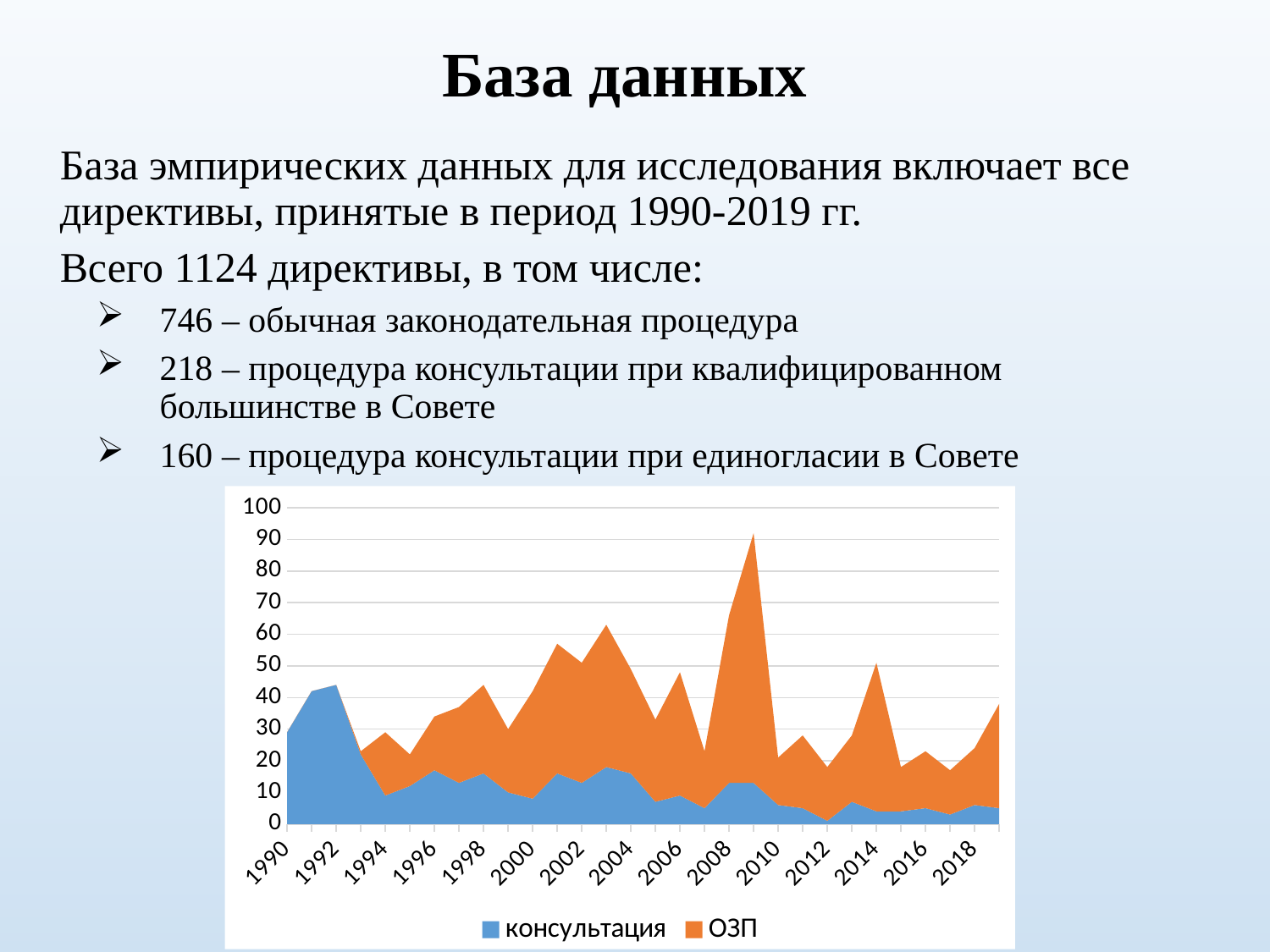
How many series does the chart legend list? 2 Does the консультация series rise or fall between 1992 and 1994? fall How many year labels are shown on the x axis of the chart? 15 What are the two series named in the chart legend? консультация and ОЗП Which series has the larger value in 2008, консультация or ОЗП? ОЗП Is the value for консультация in 2012 greater or less than 10? less Is the value for консультация larger in 1992 or in 2012? 1992 Which colour represents the ОЗП series in the chart? orange What kind of chart is shown on the slide? area chart Is the stacked total for 1990 greater or less than 40? less